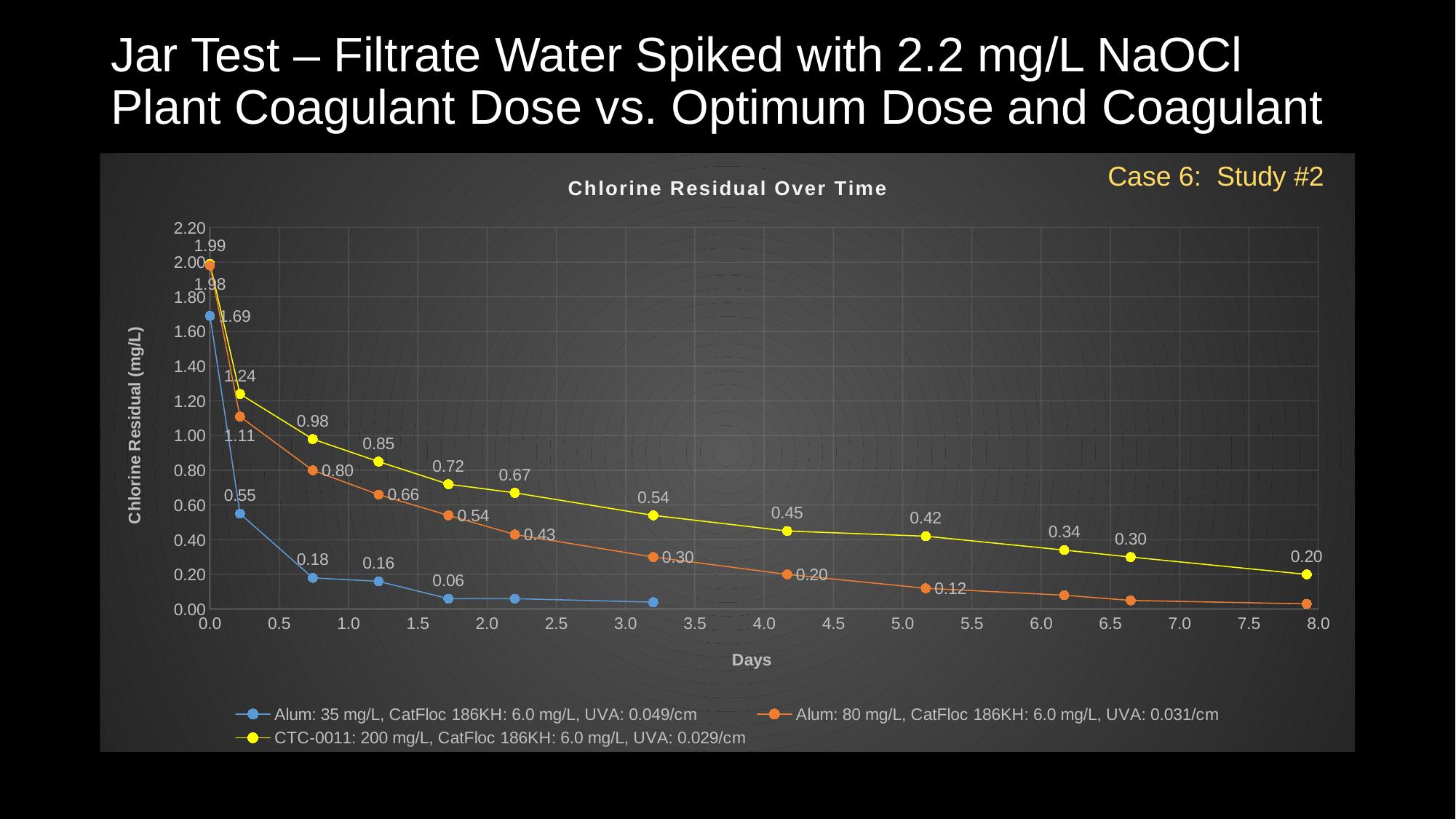
How many series does the legend list? 3 What is the chlorine residual for the CTC-0011: 200 mg/L series at the last point (day 8.0)? 0.20 Which series has the highest chlorine residual at around day 3.2? CTC-0011: 200 mg/L, CatFloc 186KH: 6.0 mg/L, UVA: 0.029/cm At around day 1.2, which series has the larger chlorine residual: CTC-0011: 200 mg/L or Alum: 80 mg/L? CTC-0011: 200 mg/L What is the title of the y axis? Chlorine Residual (mg/L) Do the chlorine residual values rise or fall over time for all three series? fall What kind of chart is shown on the slide? line chart What is the chlorine residual for the Alum: 35 mg/L series at day 0.0? 1.69 What is the lowest labeled value for the Alum: 35 mg/L series? 0.06 What is the chlorine residual for the Alum: 80 mg/L series at day 0.0? 1.98 Is the value for the Alum: 80 mg/L series at its last point (around day 7.9) greater or less than 0.20? less At around day 0.75, what is the difference between the CTC-0011 series value (0.98) and the Alum: 80 mg/L series value (0.80)? 0.18